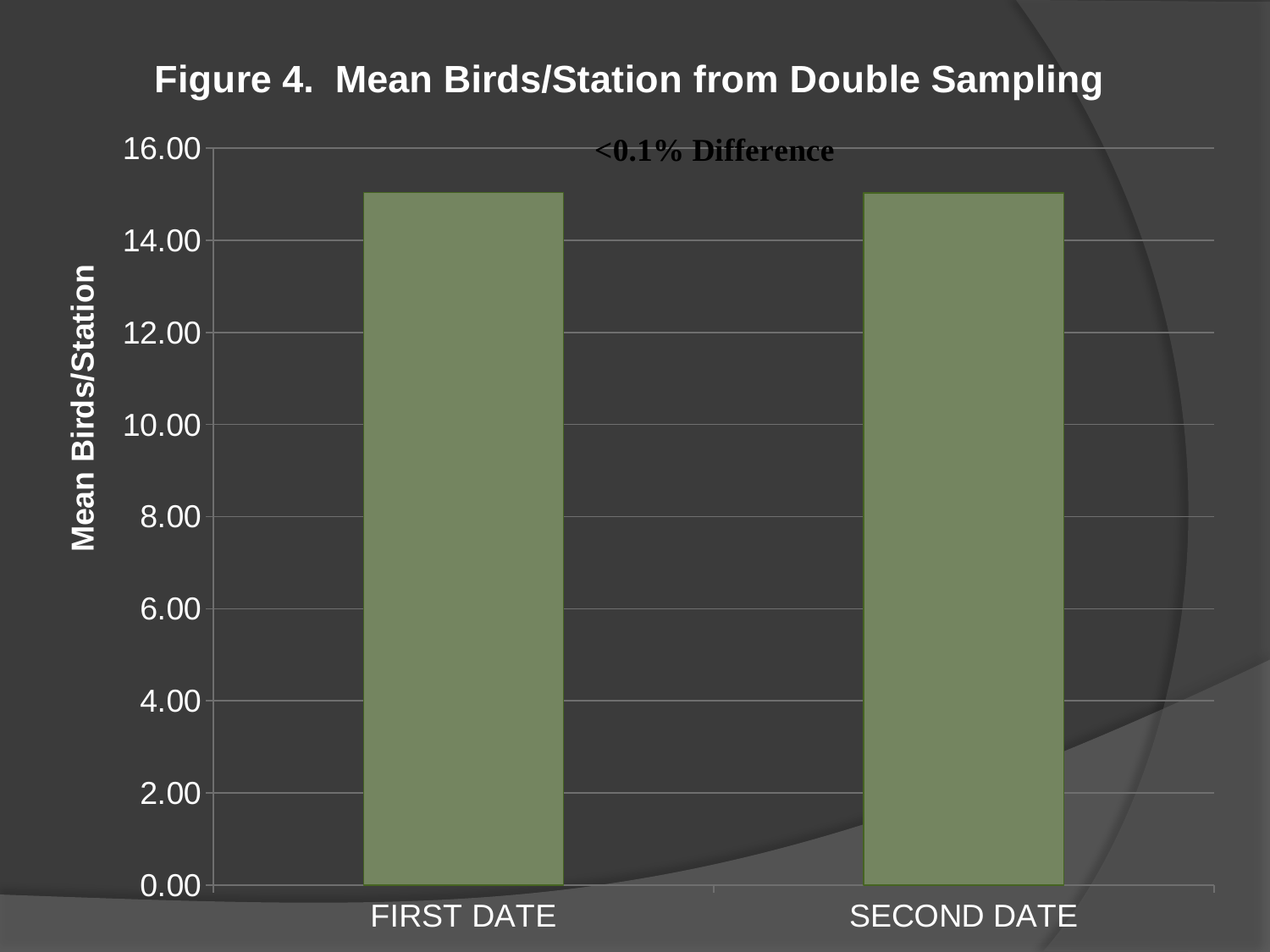
Is the value for FIRST DATE greater or less than 16.00? less Is the value for SECOND DATE greater or less than 14.00? greater Is the value for SECOND DATE greater or less than 16.00? less What are the two category labels on the x axis? FIRST DATE and SECOND DATE What kind of chart is shown on the slide? bar chart What is the title of the chart? Figure 4. Mean Birds/Station from Double Sampling How many categories are plotted on the x axis? 2 What is the label on the vertical axis? Mean Birds/Station